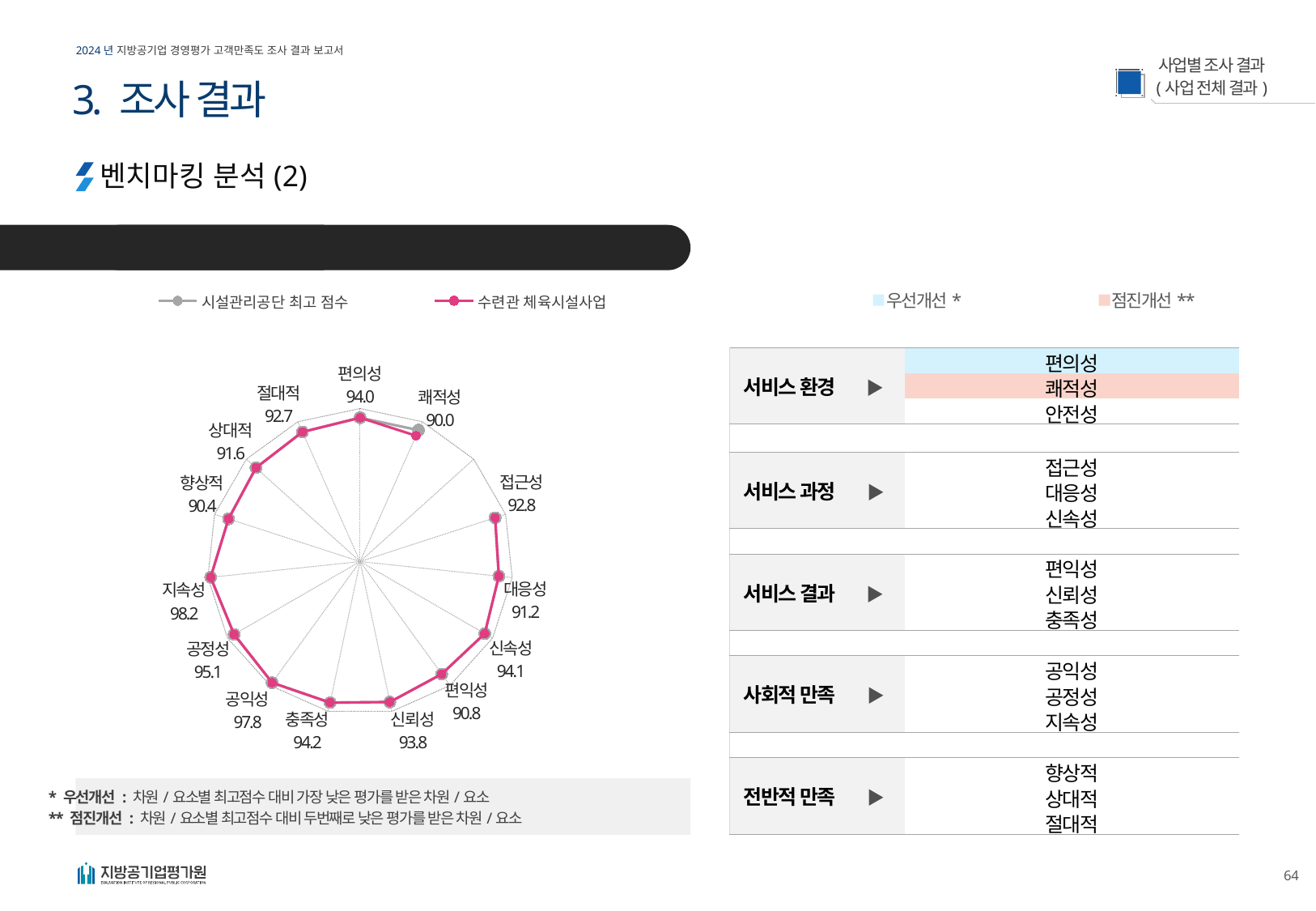
What is the difference between the labelled values for 지속성 and 쾌적성? 8.2 What value is labelled at 쾌적성 on the radar chart? 90.0 How many categories (axes) does the radar chart have? 15 Which category has the highest labelled value on the radar chart? 지속성 What kind of chart is shown on the slide? radar chart What value is labelled at 지속성 on the radar chart? 98.2 Which category has the lowest labelled value on the radar chart? 쾌적성 What value is labelled at 편의성 on the radar chart? 94.0 What value is labelled at 공익성 on the radar chart? 97.8 Which has the larger labelled value, 공정성 or 충족성? 공정성 What are the two series names shown in the chart legend? 시설관리공단 최고 점수, 수련관 체육시설사업 How many series does the chart legend list? 2